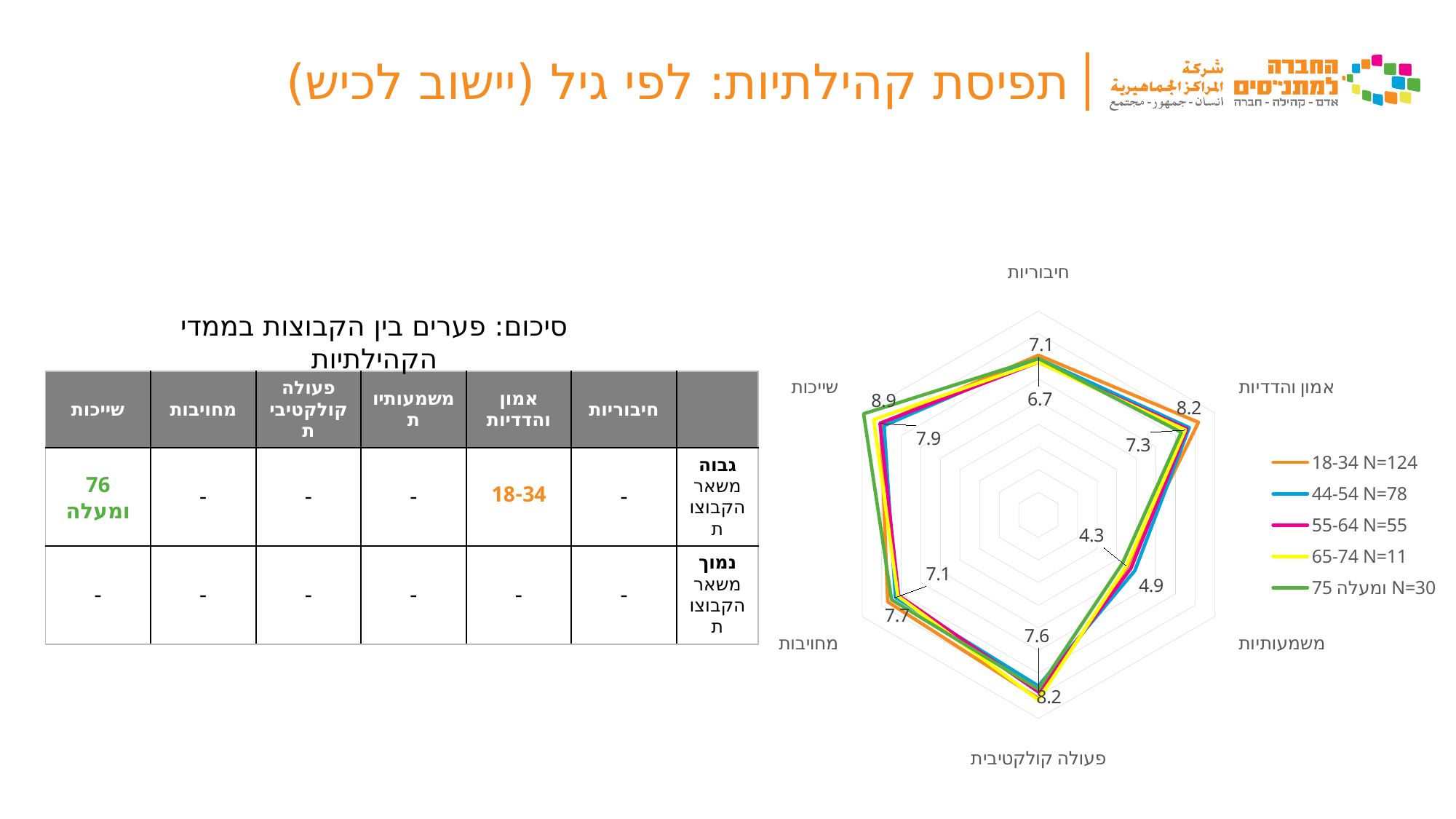
In the radar chart, what is the sample size (N) shown in the legend for the 18-34 group? N=124 In the radar chart, which age group has the highest value on the אמון והדדיות axis? 18-34 In the radar chart, what is the highest value labeled on the שייכות axis? 8.9 In the radar chart, what is the lowest value labeled on the משמעותיות axis? 4.3 How many series does the legend of the radar chart list? 5 How many axes (categories) does the radar chart have? 6 Which axis of the radar chart carries the lowest labeled value overall? משמעותיות Which axis of the radar chart carries the highest labeled value overall? שייכות In the radar chart, which is larger: the top labeled value on פעולה קולקטיבית (8.2) or the top labeled value on מחויבות (7.7)? פעולה קולקטיבית (8.2) In the radar chart, what are the two values labeled on the חיבוריות axis? 7.1 and 6.7 What kind of chart is shown on the right side of the slide? Radar chart In the radar chart, what is the difference between the two values labeled on the אמון והדדיות axis (8.2 and 7.3)? 0.9